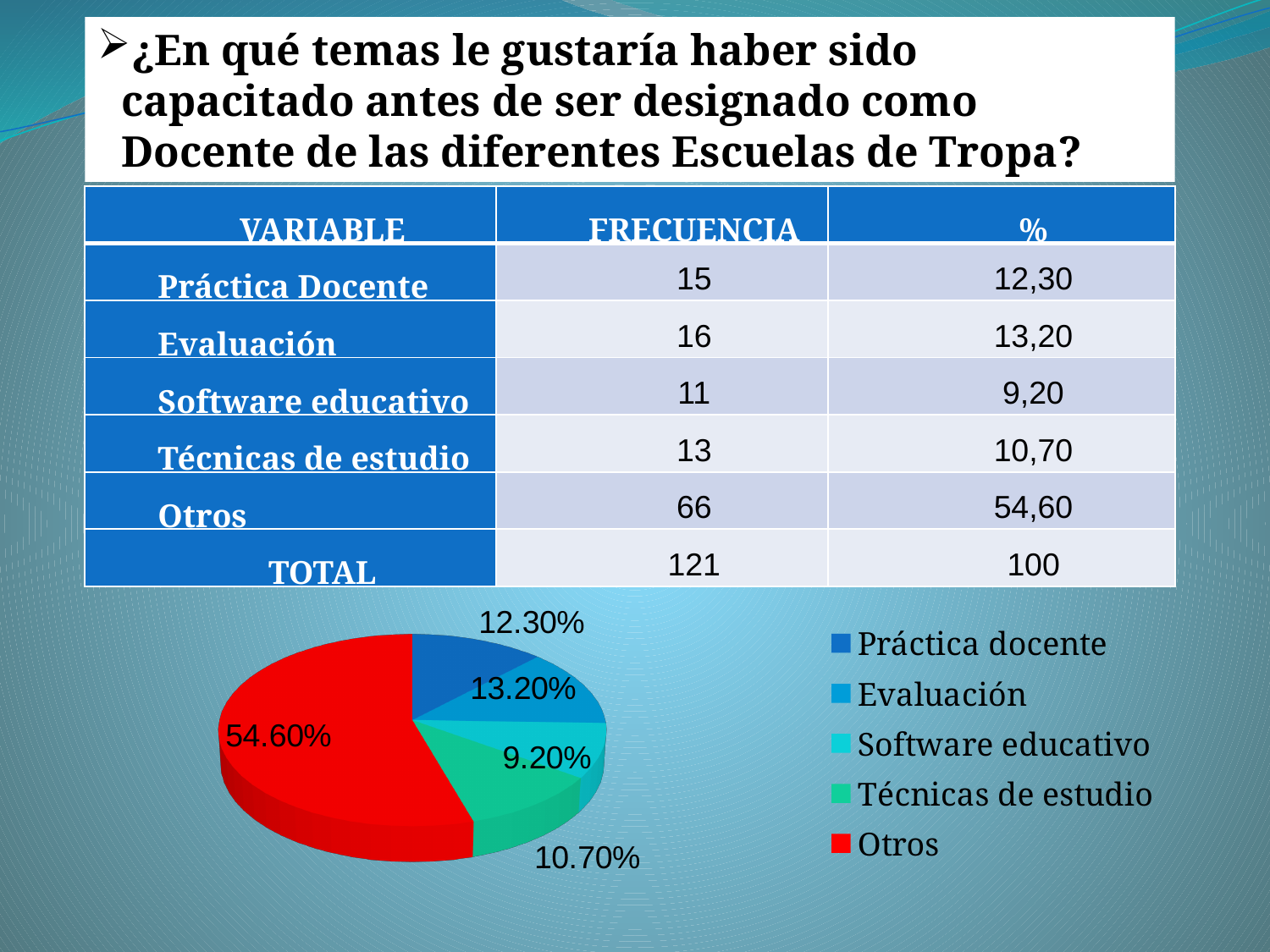
What colour is the Otros slice in the pie chart? red What percentage does the pie chart show for Evaluación? 13.20% Which category has the largest slice in the pie chart? Otros How many slices does the pie chart have? 5 Which category has the smallest slice in the pie chart? Software educativo What percentage does the pie chart show for Otros? 54.60% What percentage does the pie chart show for Técnicas de estudio? 10.70% What percentage does the pie chart show for Software educativo? 9.20% What kind of chart is shown on the slide? pie chart What is the difference in percentage points between the Otros slice and the Evaluación slice? 41.40 What percentage does the pie chart show for Práctica docente? 12.30% Which slice is larger in the pie chart, Evaluación or Práctica docente? Evaluación